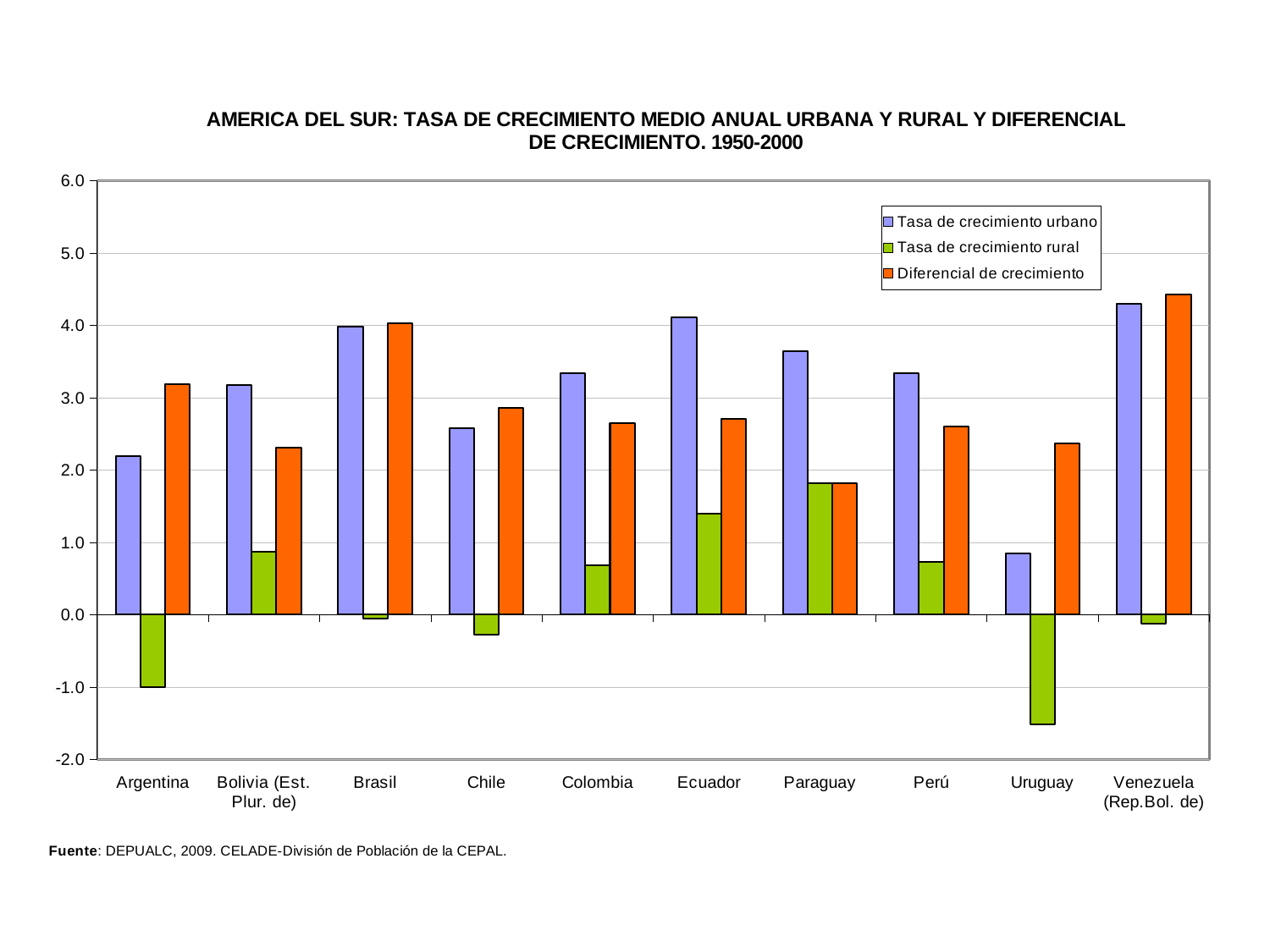
Is the value of Tasa de crecimiento urbano for Uruguay greater or less than 1.0? less Which country has the lowest value for Tasa de crecimiento rural? Uruguay Which country has the highest value for Tasa de crecimiento urbano? Venezuela (Rep.Bol. de) How many countries are shown on the x axis? 10 Is the value of Diferencial de crecimiento for Venezuela (Rep.Bol. de) greater or less than 4.0? greater How many series does the legend list? 3 Is the value of Tasa de crecimiento rural for Argentina greater or less than 0.0? less Which country has the highest value for Tasa de crecimiento rural? Paraguay What kind of chart is shown on the slide? Bar chart Which country has the lowest value for Diferencial de crecimiento? Paraguay Which country has the lowest value for Tasa de crecimiento urbano? Uruguay Which is larger, the Tasa de crecimiento urbano for Argentina or for Chile? Chile